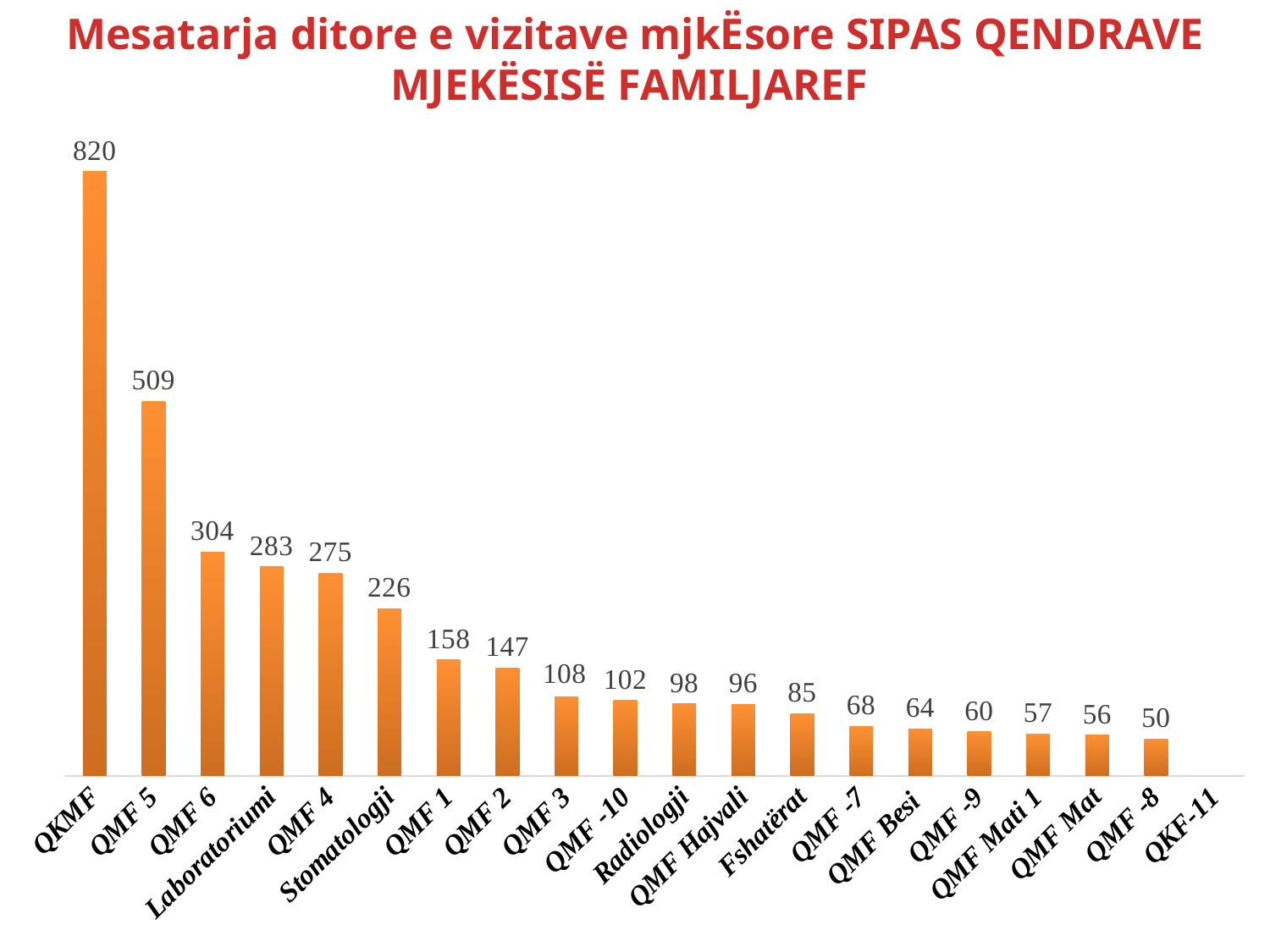
How many categories are labelled on the x axis? 20 What is the value for QMF Mati 1? 57 Do the values generally rise or fall from left to right along the x axis? Fall What is the value for Stomatologji? 226 What is the value for QKMF? 820 What kind of chart is shown on the slide? Bar chart What is the difference between the values for QMF 6 and Laboratoriumi? 21 Which category has the highest value? QKMF What is the difference between the values for QKMF and QMF 5? 311 Which is larger, the value for QMF 1 or the value for QMF 2? QMF 1 What is the value for QMF Hajvali? 96 Which is larger, the value for Radiologji or the value for Fshatërat? Radiologji